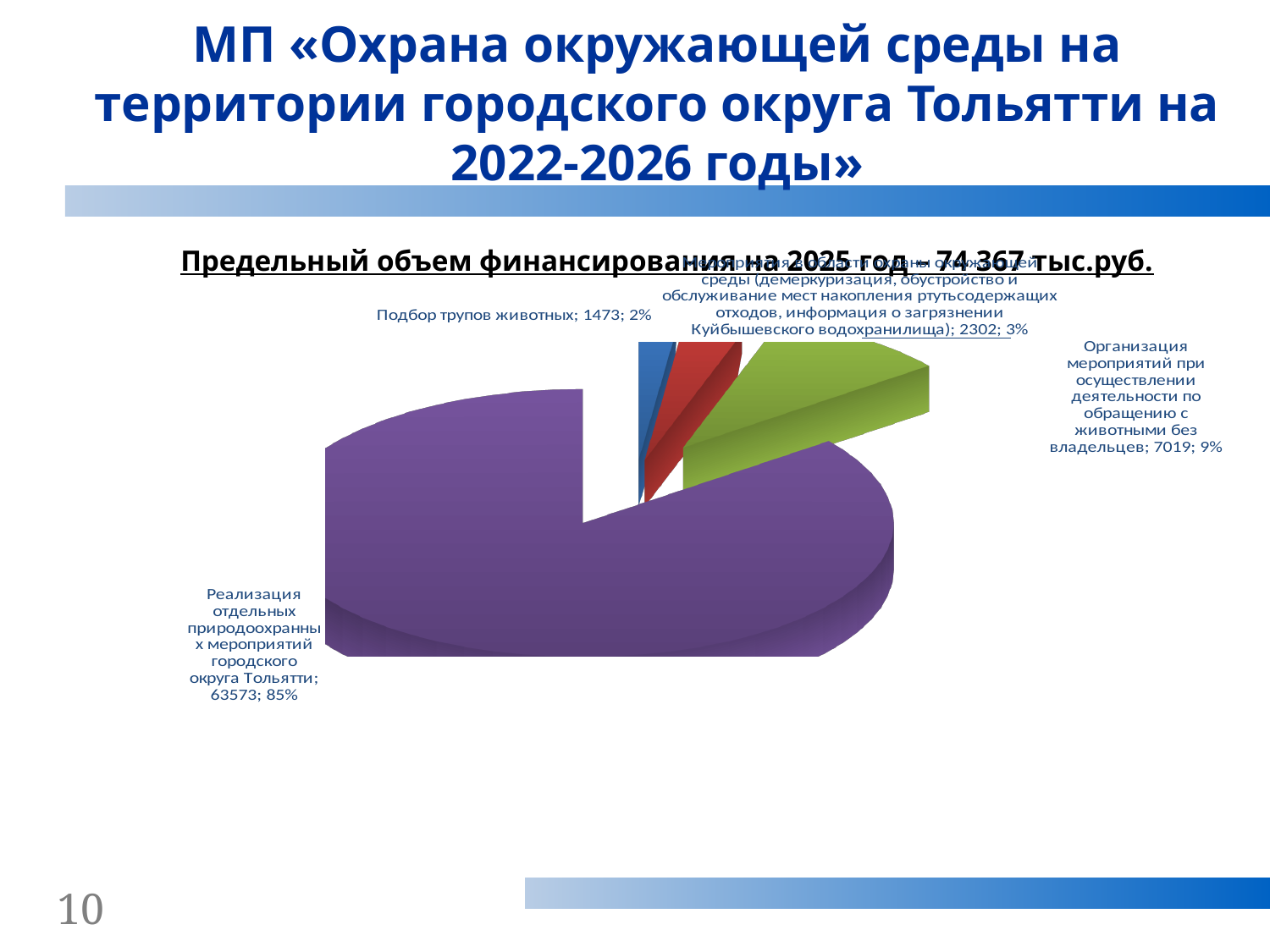
What is the value for «Реализация отдельных природоохранных мероприятий городского округа Тольятти»? 63573 What is the difference between the value for «Организация мероприятий при осуществлении деятельности по обращению с животными без владельцев» and the value for «Подбор трупов животных»? 5546 What kind of chart is shown on the slide? Pie chart What share of the pie does «Подбор трупов животных» represent? 2% How many slices does the pie chart have? 4 What share of the pie does «Реализация отдельных природоохранных мероприятий городского округа Тольятти» represent? 85% What is the value for «Подбор трупов животных»? 1473 Which category has the smallest slice of the pie? Подбор трупов животных What is the value for «Организация мероприятий при осуществлении деятельности по обращению с животными без владельцев»? 7019 What share of the pie does «Организация мероприятий при осуществлении деятельности по обращению с животными без владельцев» represent? 9% Which category has the largest slice of the pie? Реализация отдельных природоохранных мероприятий городского округа Тольятти Which is larger: the value for «Мероприятия в области охраны окружающей среды» or the value for «Подбор трупов животных»? Мероприятия в области охраны окружающей среды